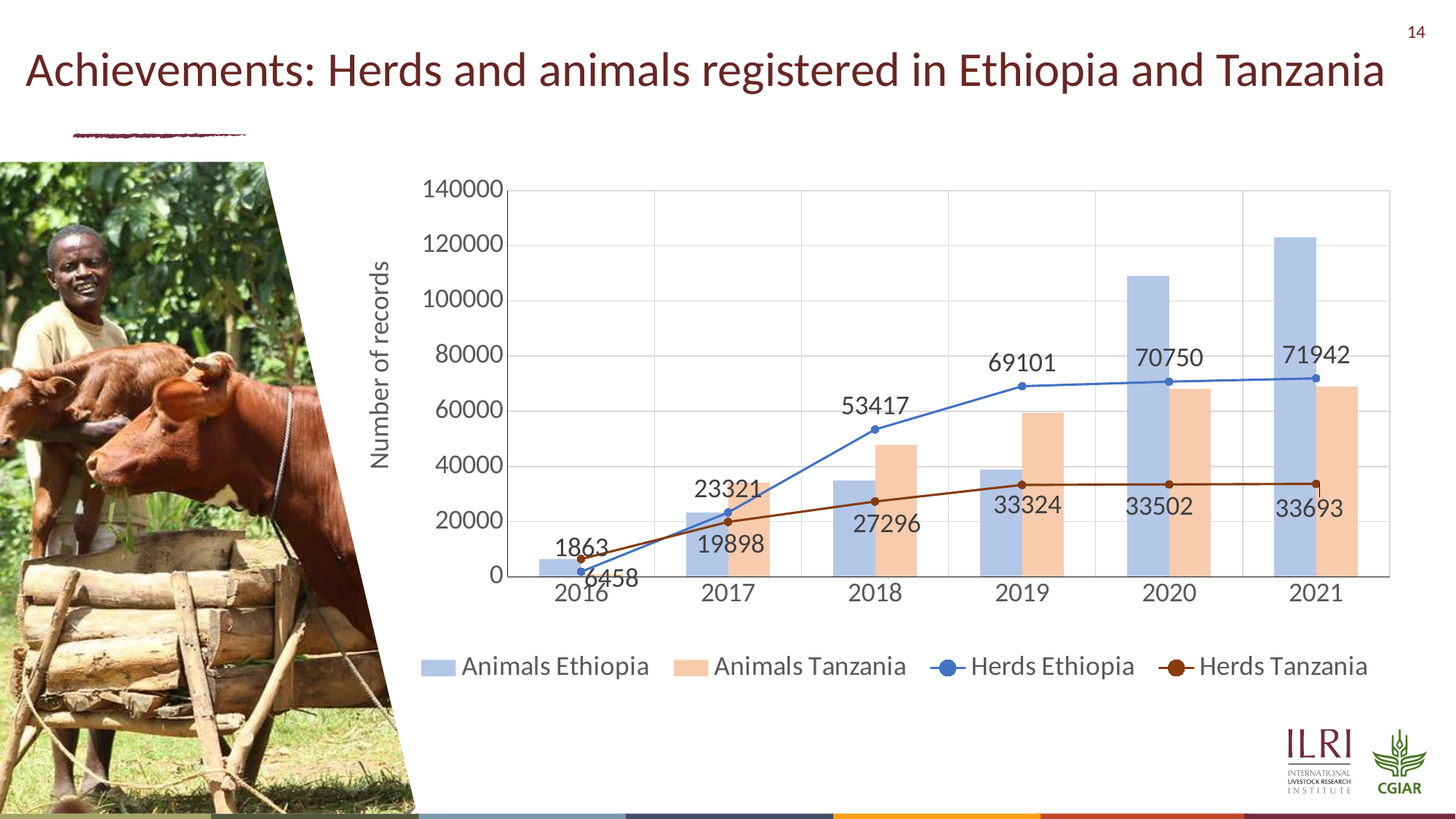
What is the value for Herds Ethiopia in 2017? 23321 Is the value for Animals Ethiopia in 2021 greater or less than 100000? greater In which year is Herds Ethiopia highest? 2021 Which is larger in 2020, Animals Ethiopia or Animals Tanzania? Animals Ethiopia What is the value for Herds Tanzania in 2021? 33693 In which year is Herds Tanzania lowest? 2016 What is the difference between Herds Ethiopia and Herds Tanzania in 2021? 38249 Is the value for Animals Tanzania in 2019 greater or less than 40000? greater How many series does the legend list? 4 How many years are shown on the x axis? 6 What is the value for Herds Ethiopia in 2019? 69101 By how much did Herds Ethiopia increase from 2017 to 2018? 30096